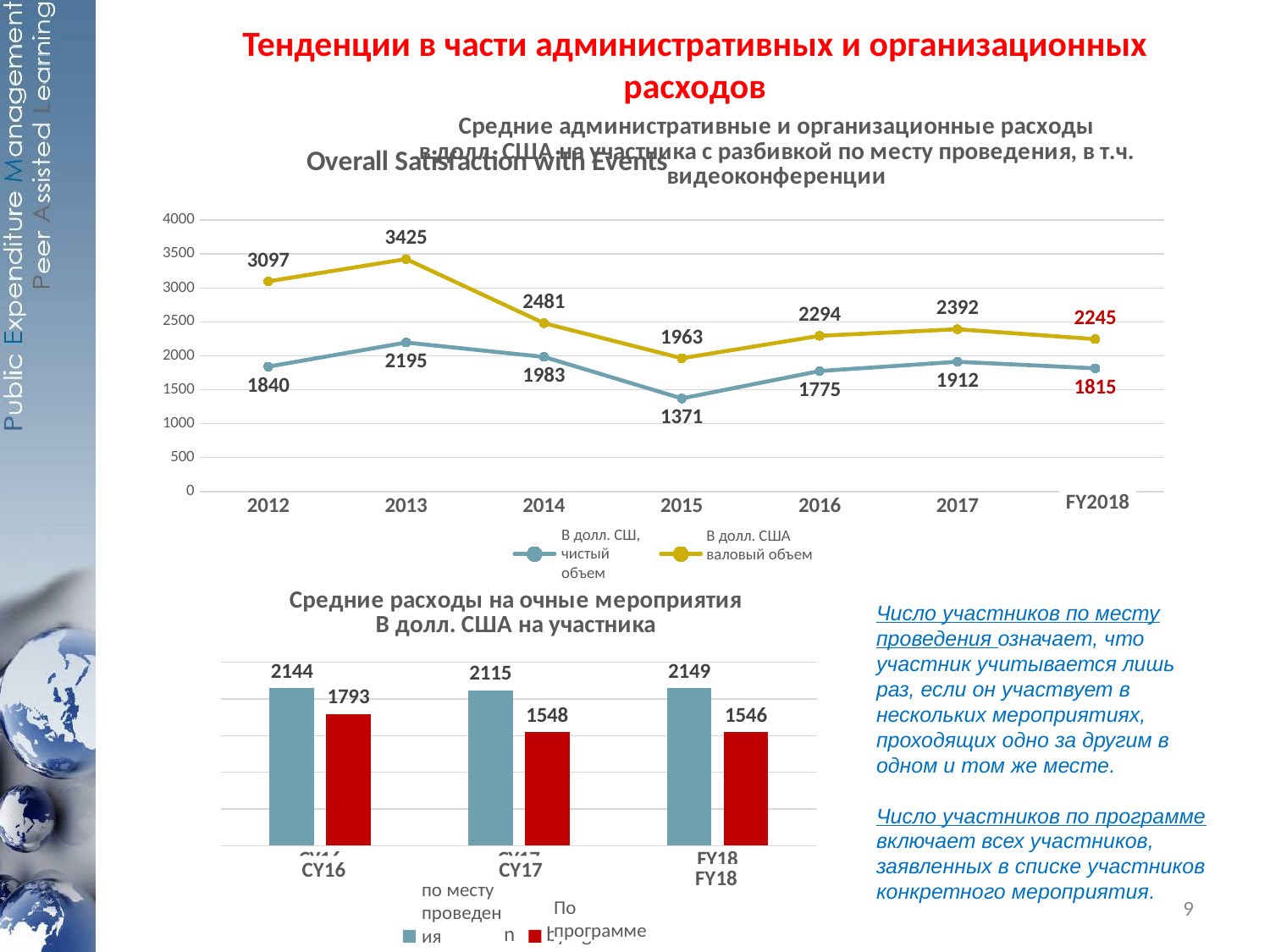
In the bottom bar chart 'Средние расходы на очные мероприятия', what is the difference between 'по месту проведения' and 'По программе' in FY18? 603 In the top line chart, what is the difference between the gross volume and net volume values for FY2018? 430 In the top line chart, which year has the lowest value for the net volume (чистый объем) series? 2015 In the bottom bar chart 'Средние расходы на очные мероприятия', what is the value for 'По программе' in CY17? 1548 What kind of chart is the bottom chart titled 'Средние расходы на очные мероприятия'? bar chart In the bottom bar chart 'Средние расходы на очные мероприятия', which is larger in CY16: 'по месту проведения' or 'По программе'? по месту проведения In the top line chart, does the gross volume (валовый объем) series rise or fall from 2013 to 2015? fall In the top line chart, how many years are shown on the x axis? 7 In the top line chart, what is the value of the net volume (чистый объем) series for 2015? 1371 In the top line chart, what is the value of the gross volume (валовый объем) series for 2013? 3425 In the top line chart, how many series does the legend list? 2 In the top line chart, which year has the highest value for the gross volume (валовый объем) series? 2013